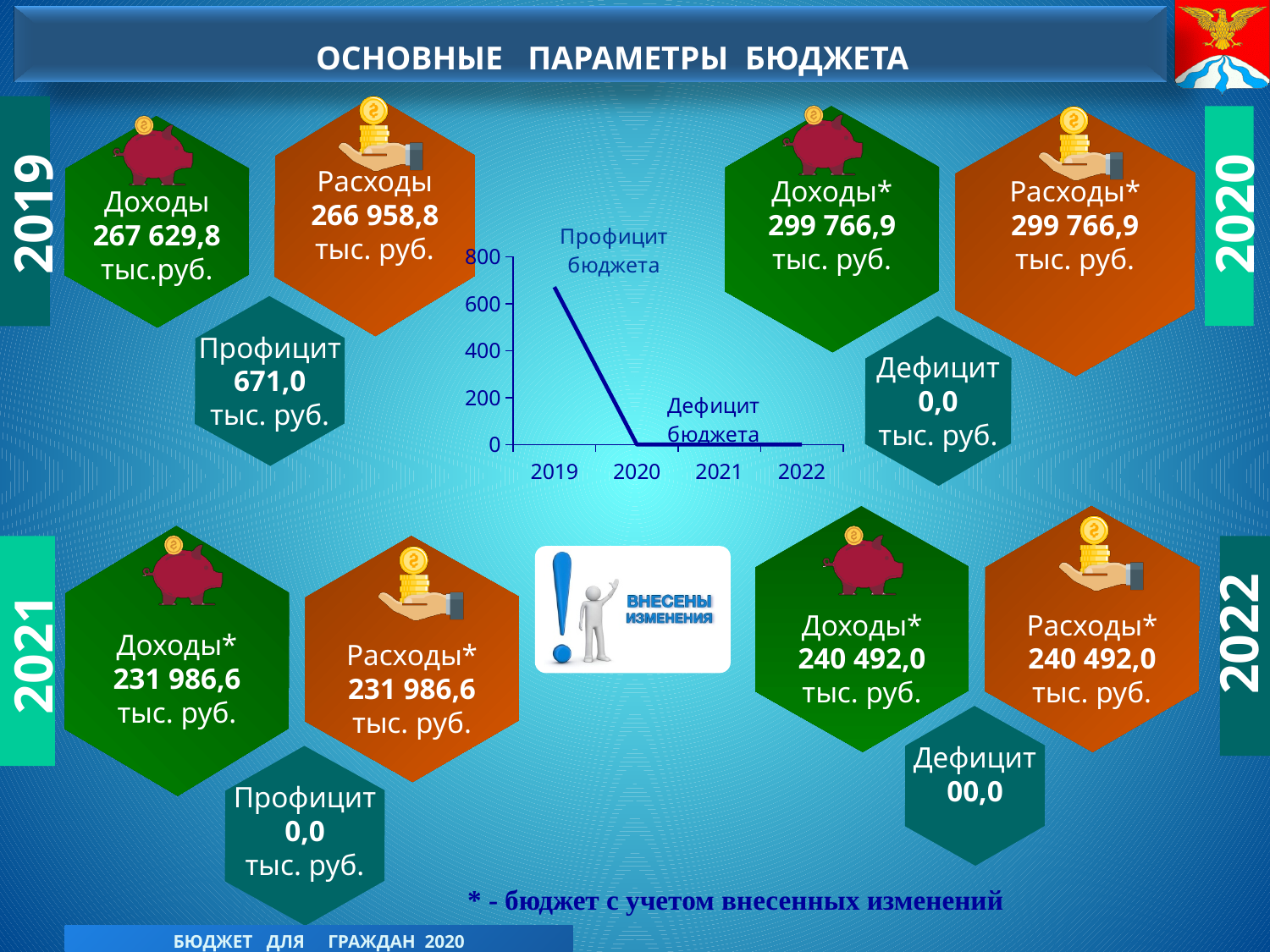
What value does the line chart show for 2020? 0 How many years are plotted along the x axis of the line chart? 4 What kind of chart is shown in the centre of the slide? Line chart Is the value for 2019 on the line chart greater or less than 600? greater On the line chart, which year has the larger value, 2019 or 2021? 2019 Which year has the highest value on the line chart? 2019 What are the two text labels placed on the line chart? Профицит бюджета and Дефицит бюджета Is the value for 2019 on the line chart greater or less than 800? less What value does the line chart show for 2022? 0 What is the highest tick shown on the y axis of the line chart? 800 Do the values on the line chart rise or fall from 2019 to 2020? Fall